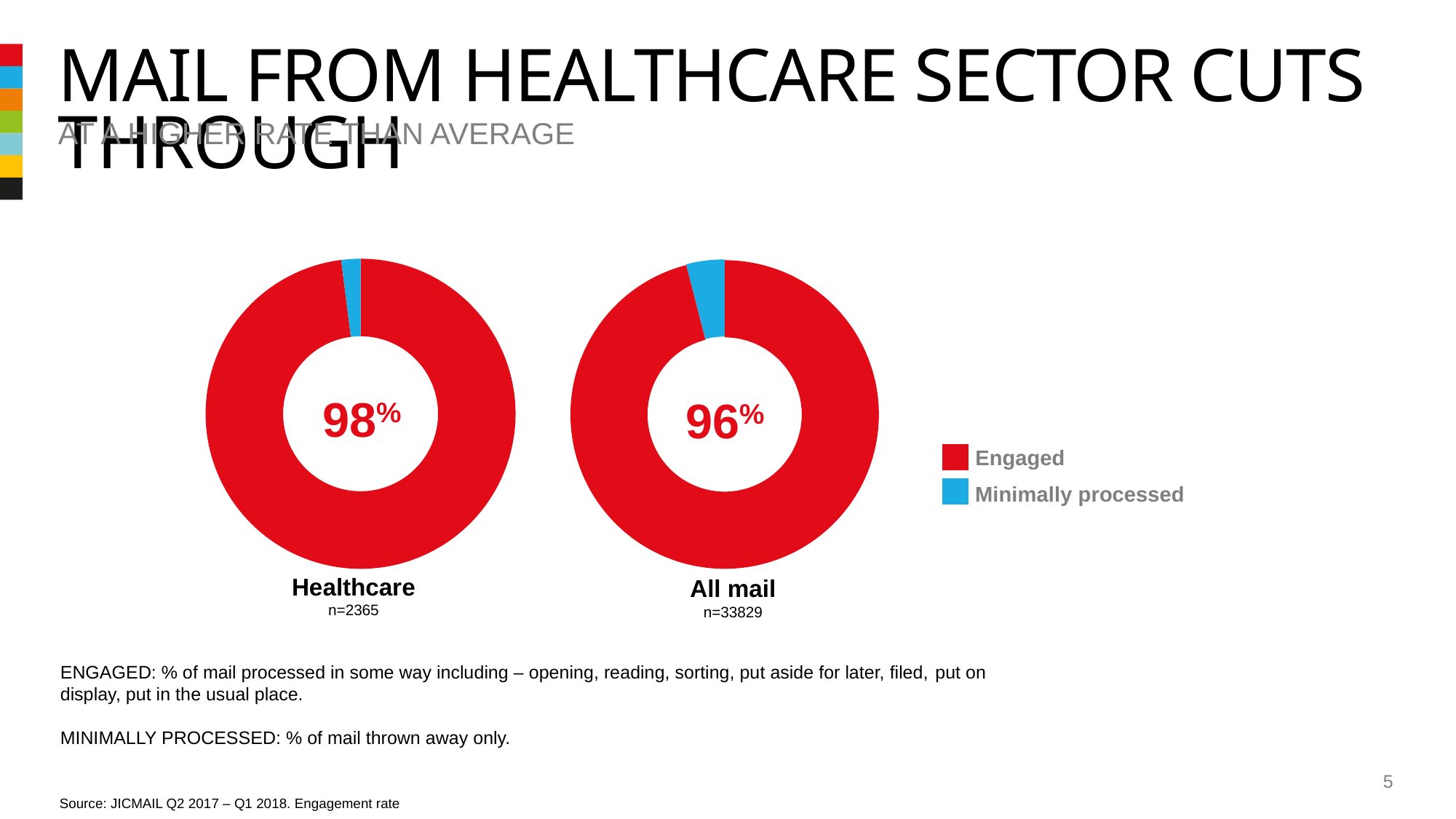
What colour represents Minimally processed in the legend? Blue In the Healthcare chart, what share of the donut does the Engaged segment represent? 98% How many series does the legend list? 2 In the All mail chart, is the Engaged share greater or less than 90%? greater How many donut charts are shown on the slide? 2 What kind of chart is used to show the Healthcare engagement rate? Donut (pie) chart What is the difference in percentage points between the Engaged share for Healthcare and for All mail? 2 percentage points In the All mail chart, what percentage of mail is Engaged? 96% Which chart shows the higher Engaged percentage, Healthcare or All mail? Healthcare In the Healthcare chart, which segment is larger, Engaged or Minimally processed? Engaged In the Healthcare chart, what percentage of mail is Engaged? 98% What is the sample size (n) shown under the Healthcare chart? n=2365